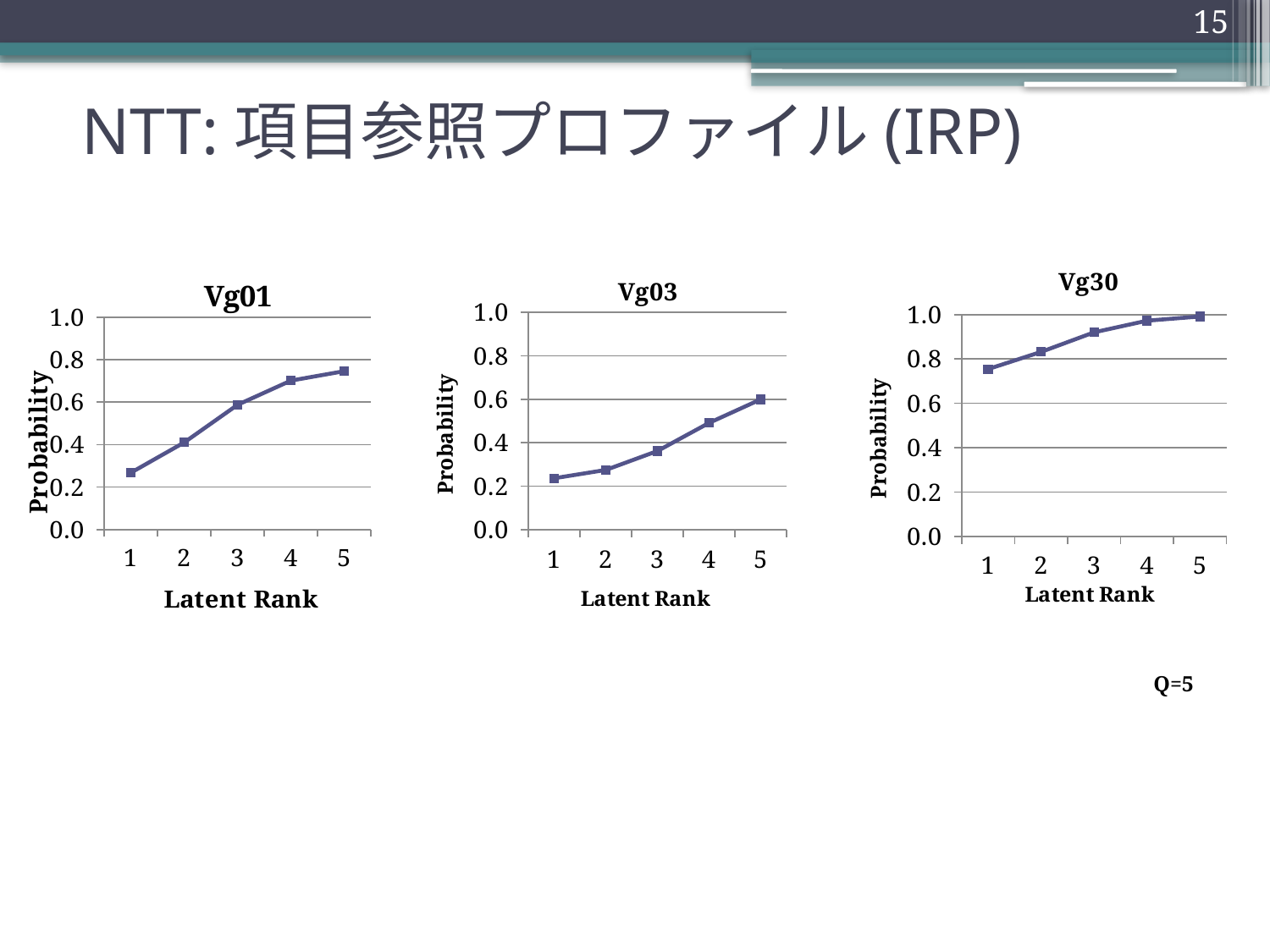
In the Vg01 chart, is the value for Latent Rank 5 greater or less than 0.6? greater In the Vg03 chart, is the value for Latent Rank 4 greater or less than 0.4? greater At Latent Rank 3, which chart shows the larger probability, Vg01 or Vg03? Vg01 In the Vg30 chart, do the values rise or fall as Latent Rank increases from 1 to 5? rise In the Vg01 chart, is the value for Latent Rank 1 greater or less than 0.4? less What is the label on the vertical axis of the Vg30 chart? Probability What kind of chart is the Vg01 chart? line chart How many data points are plotted in the Vg03 chart? 5 In the Vg01 chart, which Latent Rank has the highest probability? 5 In the Vg01 chart, do the values rise or fall as Latent Rank increases from 1 to 5? rise In the Vg03 chart, which Latent Rank has the lowest probability? 1